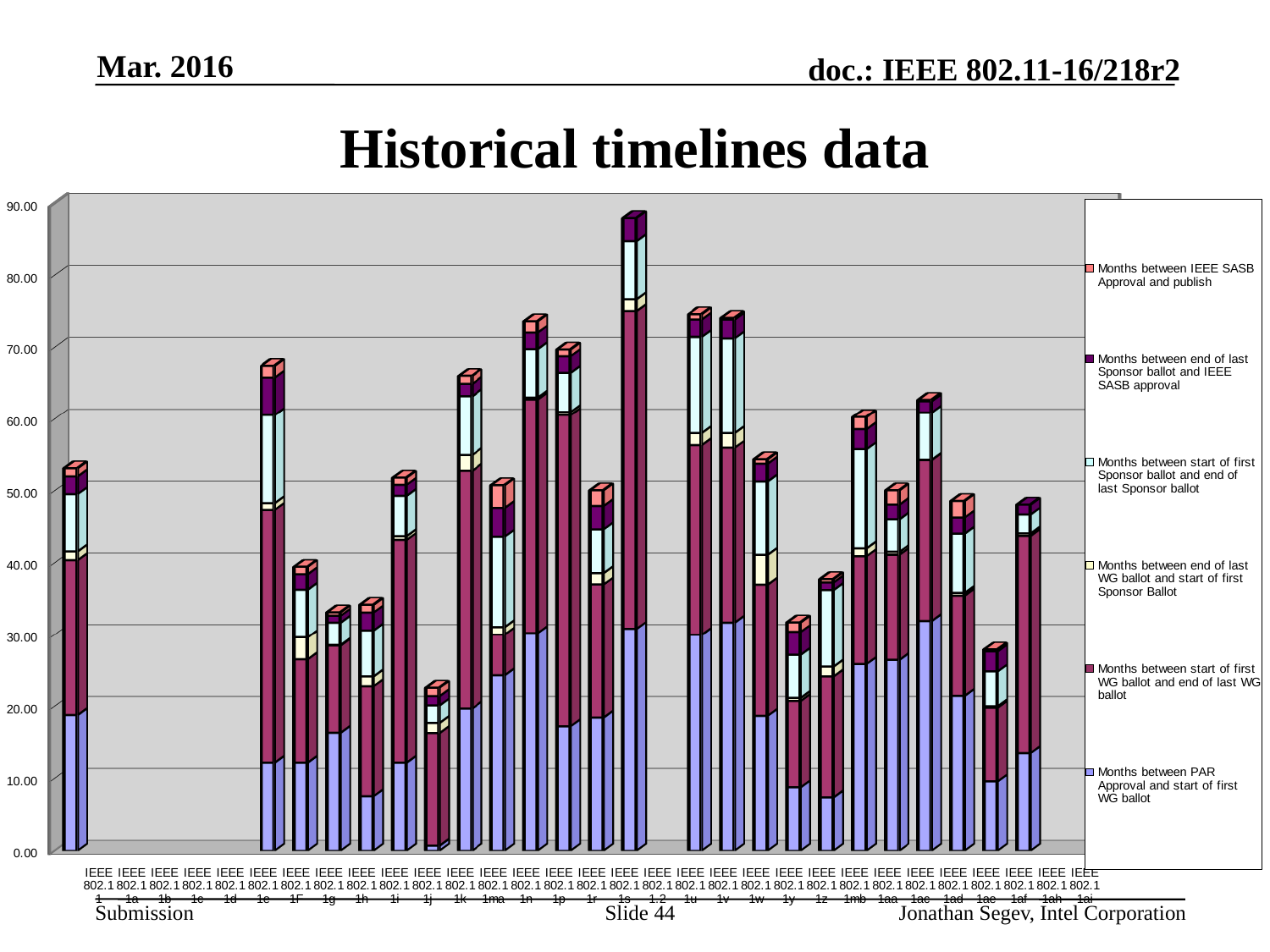
Which legend entry corresponds to the bottom segment of each stacked bar? Months between PAR Approval and start of first WG ballot Is the total stacked value for IEEE 802.11n greater or less than 70? greater How many series does the legend list? 6 Is the total of the tallest stacked bar greater or less than 80? greater Is the total stacked value for IEEE 802.11j greater or less than 30? less What kind of chart is shown on the slide? stacked bar chart Which has the larger total stacked value, IEEE 802.11s or IEEE 802.11j? IEEE 802.11s What is the title of the chart? Historical timelines data